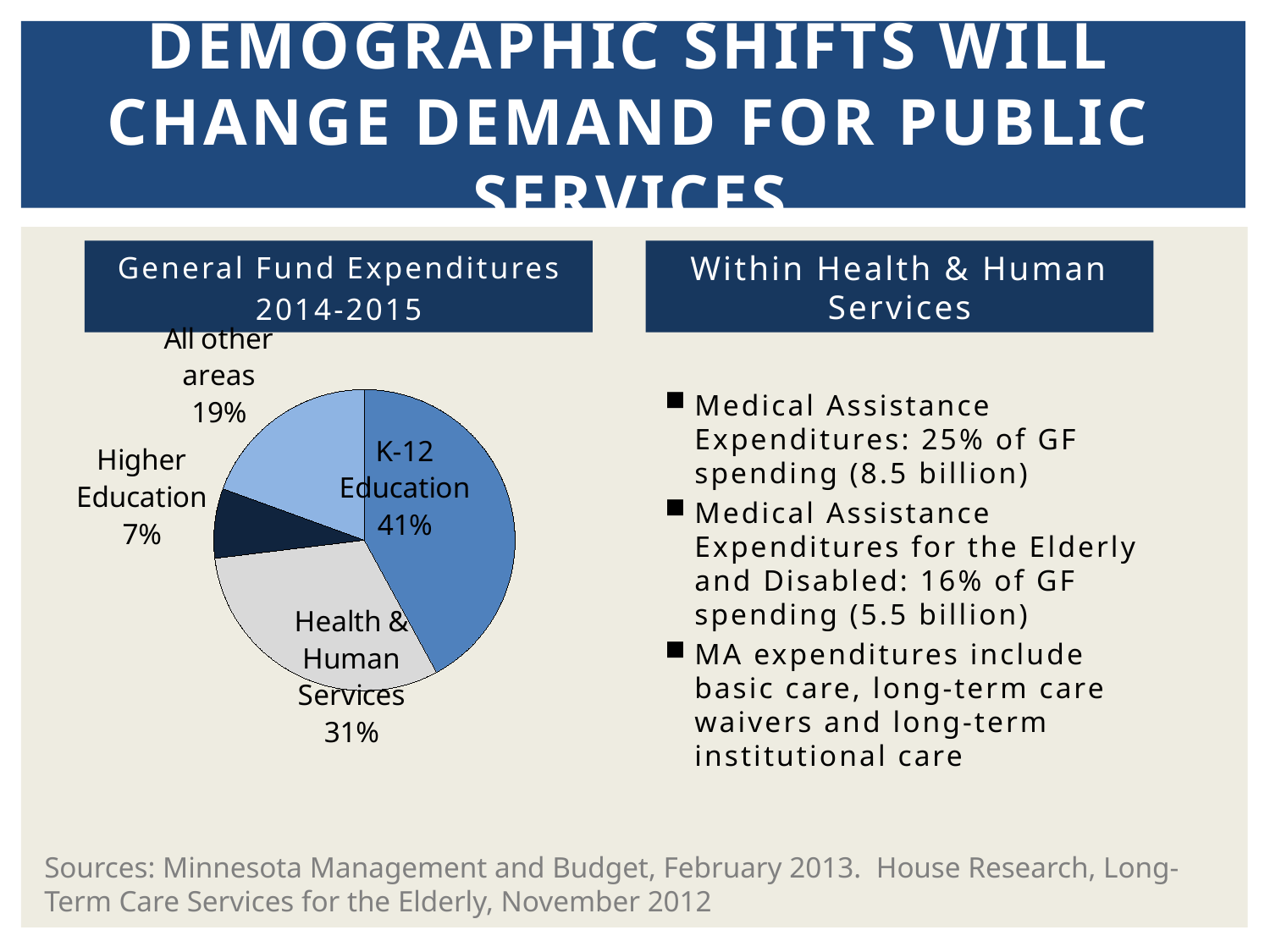
What share of General Fund Expenditures 2014-2015 goes to Health & Human Services? 31% What is the combined share of K-12 Education and Higher Education? 48% How many slices does the pie chart have? 4 How many percentage points larger is the K-12 Education share than the Health & Human Services share? 10 What is the title of the pie chart? General Fund Expenditures 2014-2015 What share of General Fund Expenditures 2014-2015 goes to All other areas? 19% Which category has the largest share of General Fund Expenditures 2014-2015? K-12 Education Which category has the smallest share of General Fund Expenditures 2014-2015? Higher Education What share of General Fund Expenditures 2014-2015 goes to K-12 Education? 41% What share of General Fund Expenditures 2014-2015 goes to Higher Education? 7% What type of chart is shown on the slide? Pie chart Which is larger: the share for All other areas or the share for Higher Education? All other areas